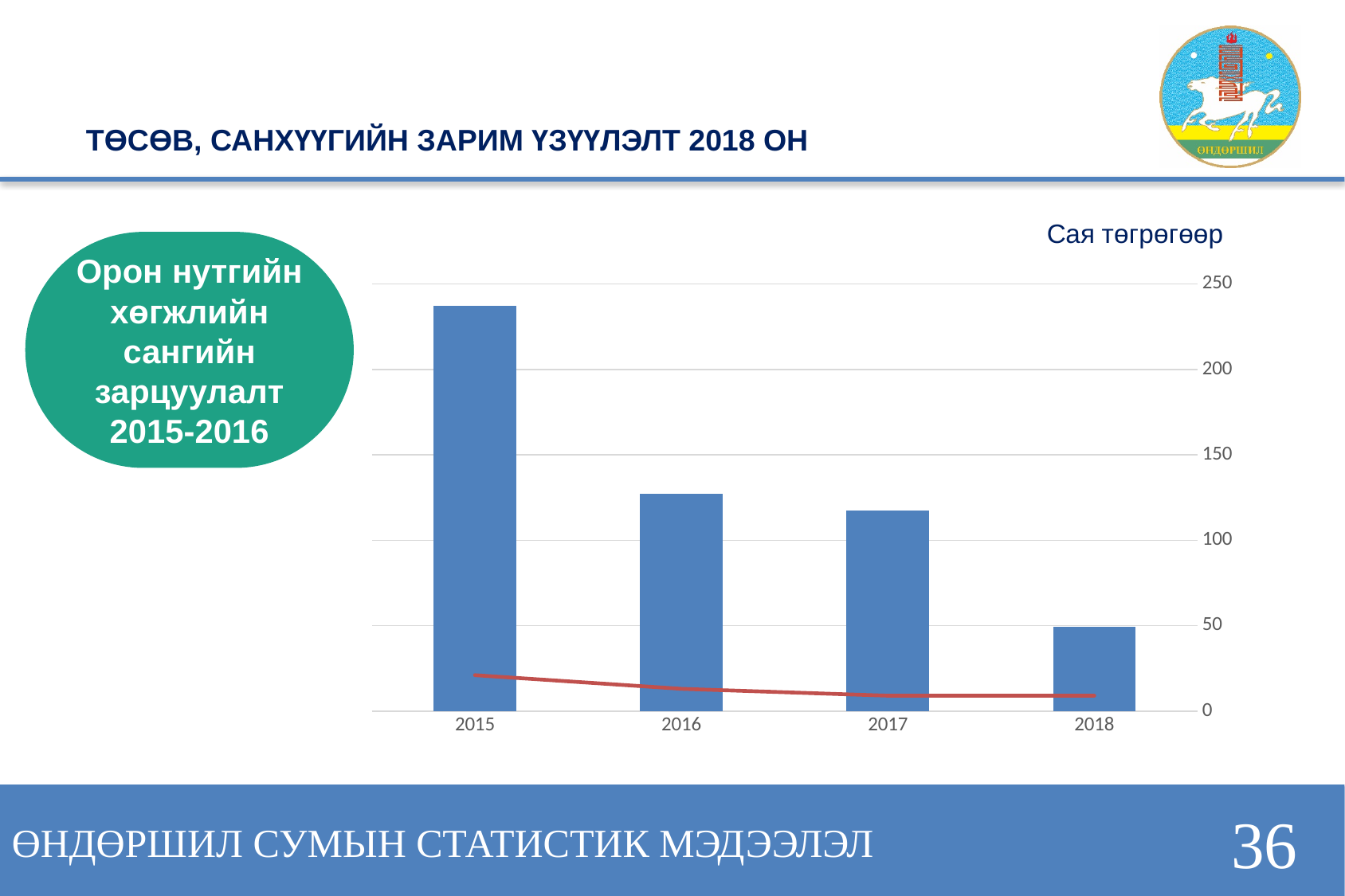
Do the bar values rise or fall from 2015 to 2018? fall Which year has the lowest bar in the chart? 2018 Which year has the highest bar in the chart? 2015 Is the value for 2018 greater or less than 100? less What unit label is shown above the chart? Сая төгрөгөөр What kind of chart is shown on the slide? combination bar and line chart Is the value for 2016 greater or less than 150? less Is the value for 2017 greater or less than 100? greater Which year has the larger bar, 2015 or 2016? 2015 How many years are shown on the x axis of the chart? 4